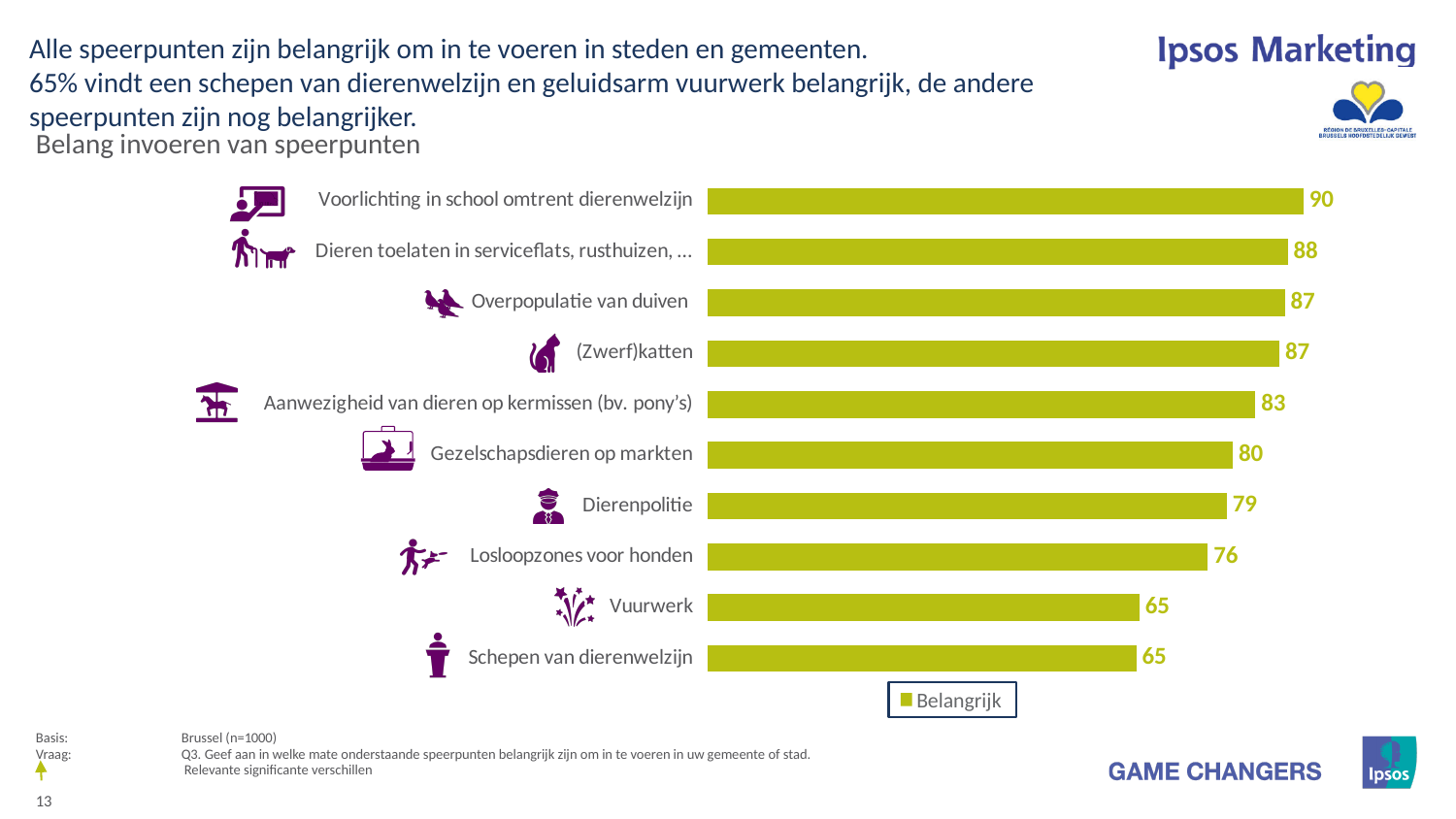
How many categories are shown in the chart? 10 What is the difference between the values for Gezelschapsdieren op markten and Losloopzones voor honden? 4 How many series does the legend list? 1 What is the value for Dierenpolitie? 79 What is the legend entry of the chart? Belangrijk Which is larger: the value for Overpopulatie van duiven or the value for Aanwezigheid van dieren op kermissen (bv. pony's)? Overpopulatie van duiven What is the value for Losloopzones voor honden? 76 What is the lowest value shown in the chart? 65 Which category has the highest value? Voorlichting in school omtrent dierenwelzijn What is the difference between the values for Voorlichting in school omtrent dierenwelzijn and Schepen van dierenwelzijn? 25 What kind of chart is shown on the slide? Bar chart What is the value for Voorlichting in school omtrent dierenwelzijn? 90